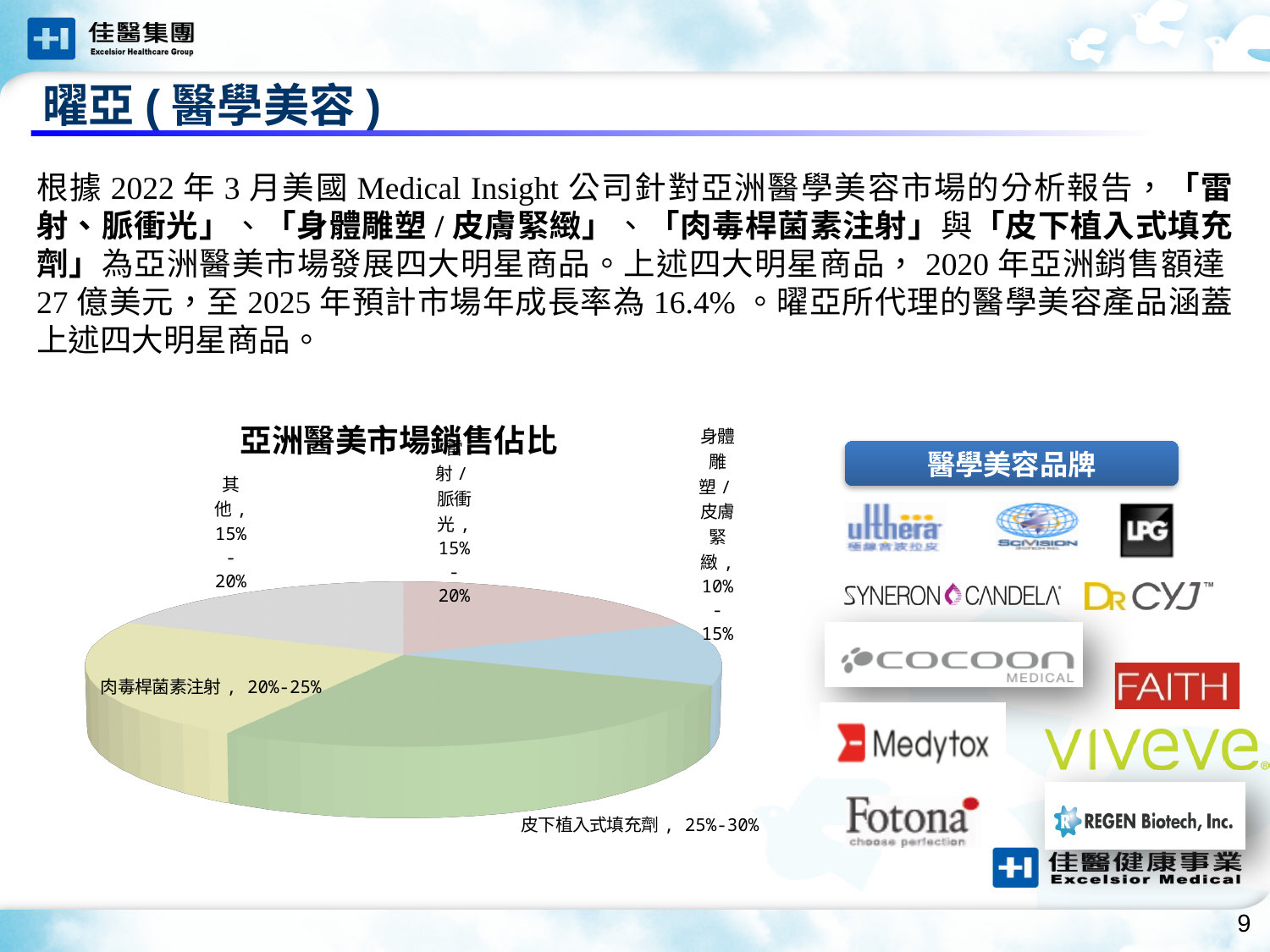
What share is shown for 其他 in the pie chart? 15%-20% Which has the larger share in the pie chart, 肉毒桿菌素注射 or 身體雕塑/皮膚緊緻? 肉毒桿菌素注射 Which category has the smallest share in the pie chart? 身體雕塑/皮膚緊緻 What is the title of the pie chart? 亞洲醫美市場銷售佔比 What share is shown for 肉毒桿菌素注射 in the pie chart? 20%-25% What share of the Asian medical aesthetics market does 皮下植入式填充劑 hold according to the pie chart? 25%-30% What share is shown for 身體雕塑/皮膚緊緻 in the pie chart? 10%-15% Which has the larger share in the pie chart, 皮下植入式填充劑 or 雷射/脈衝光? 皮下植入式填充劑 Which category has the largest share in the pie chart? 皮下植入式填充劑 How many slices does the pie chart have? 5 What kind of chart is shown on the slide? pie chart What share is shown for 雷射/脈衝光 in the pie chart? 15%-20%